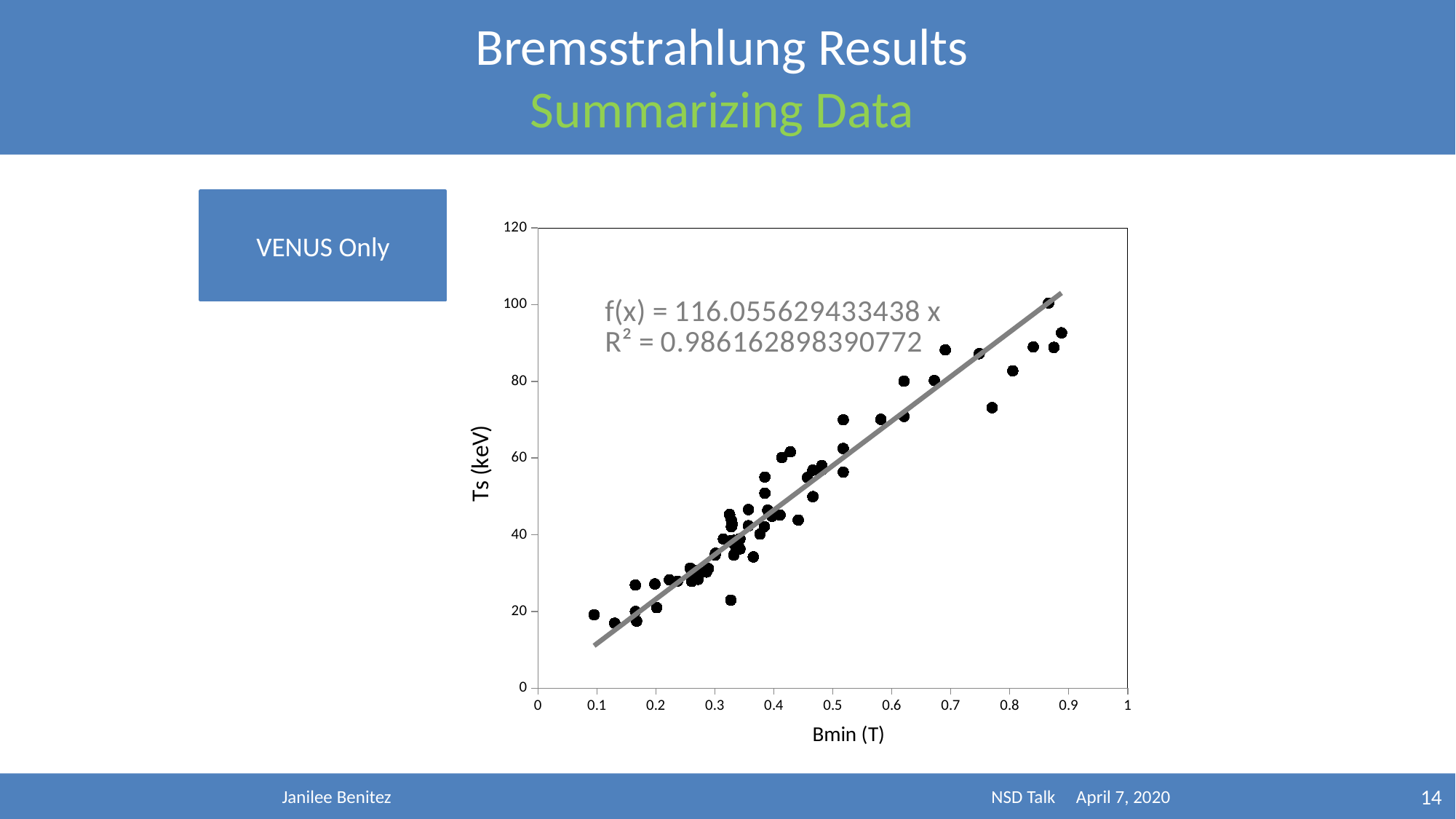
What is the R² value printed on the chart? 0.986162898390772 What is the trendline equation printed on the chart? f(x) = 116.055629433438 x Do the Ts values generally rise or fall as Bmin increases? rise Is the lowest Ts value plotted greater or less than 40? less Is the Ts value of the point with the largest Bmin greater or less than 80? greater Which point has the higher Ts value: the one with the smallest Bmin or the one with the largest Bmin? the one with the largest Bmin Are the points with Bmin below 0.2 T above or below 40 keV? below What kind of chart is shown on the slide? scatter chart